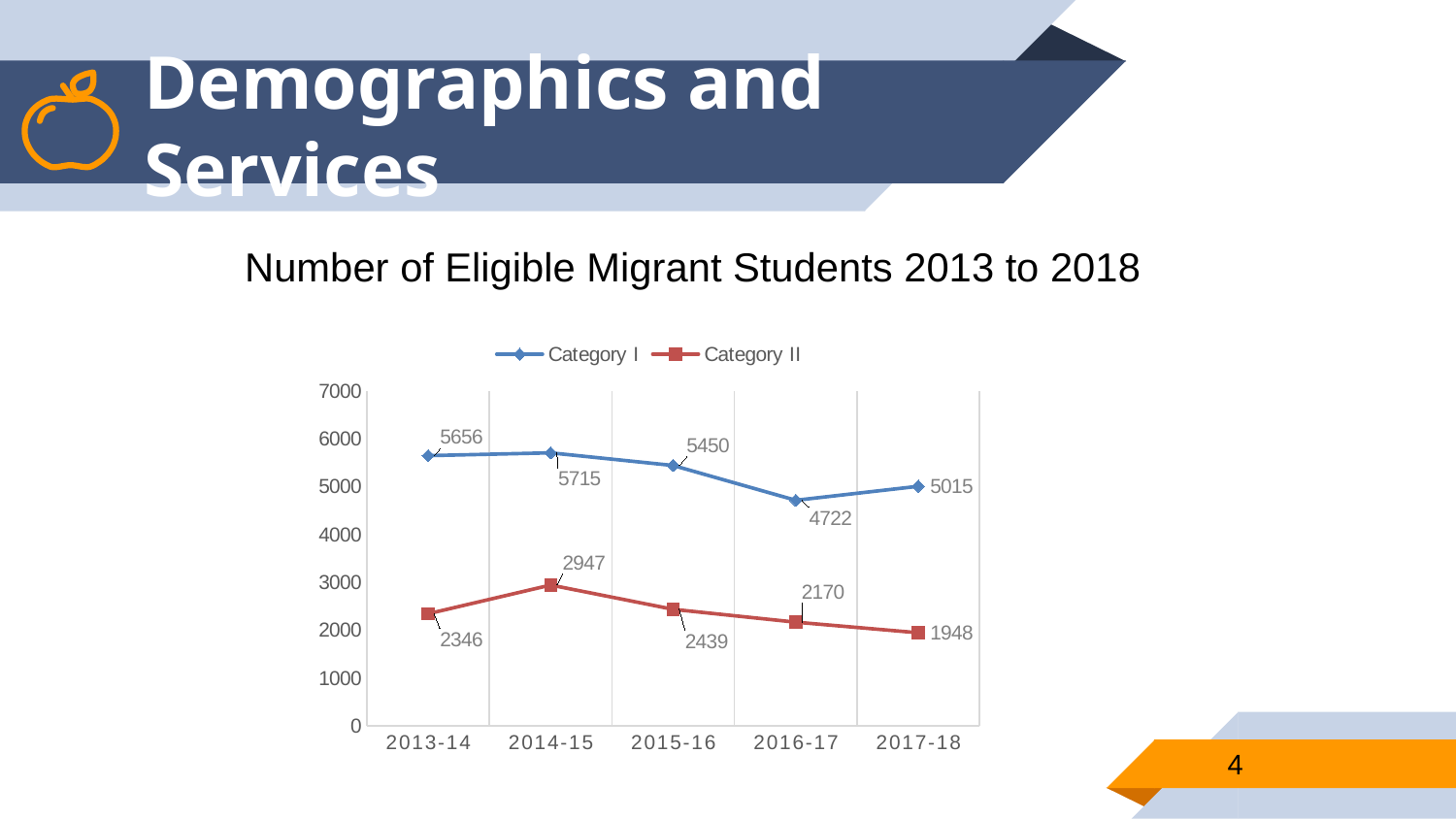
What is the value for Category II in 2017-18? 1948 What kind of chart is this? line chart In which year is Category II lowest? 2017-18 What is the value for Category II in 2014-15? 2947 Does Category II rise or fall from 2014-15 to 2017-18? fall What is the difference between Category I and Category II in 2016-17? 2552 Which is larger, Category I in 2015-16 or Category I in 2017-18? Category I in 2015-16 In which year is Category I highest? 2014-15 How many years are shown on the x axis? 5 What is the value for Category I in 2013-14? 5656 What is the title of the chart? Number of Eligible Migrant Students 2013 to 2018 How many series does the legend list? 2